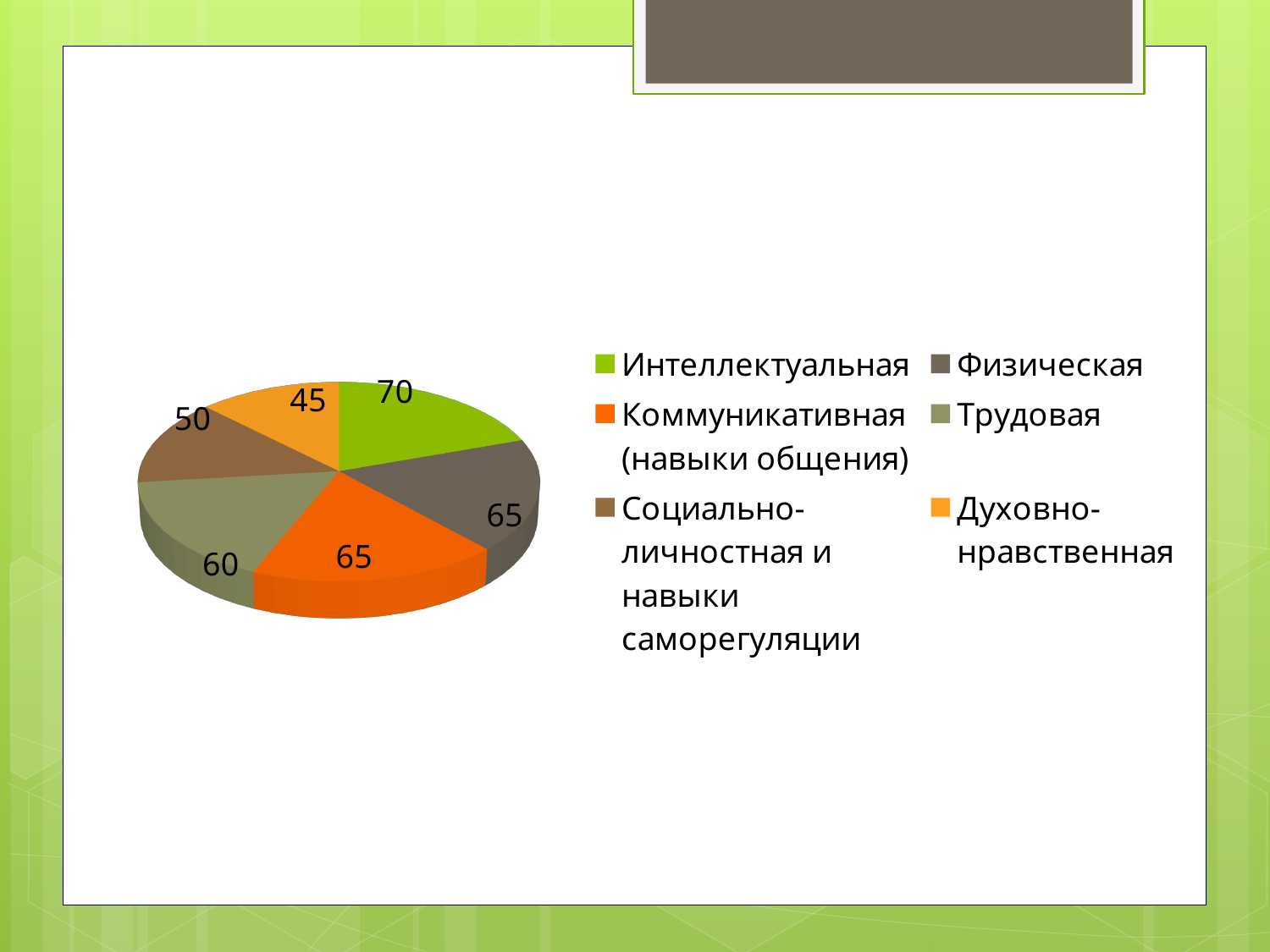
What kind of chart is shown on the slide? Pie chart Which category has the largest slice in the pie chart? Интеллектуальная What value is shown for the Интеллектуальная slice of the pie chart? 70 Which category has the smallest slice in the pie chart? Духовно-нравственная Which is larger, the Трудовая value or the Социально-личностная и навыки саморегуляции value? Трудовая What is the difference between the Интеллектуальная value and the Духовно-нравственная value? 25 What value is shown for the Трудовая slice? 60 How many slices does the pie chart have? 6 What value is shown for the Физическая slice? 65 What value is shown for the Социально-личностная и навыки саморегуляции slice? 50 What value is shown for the Духовно-нравственная slice? 45